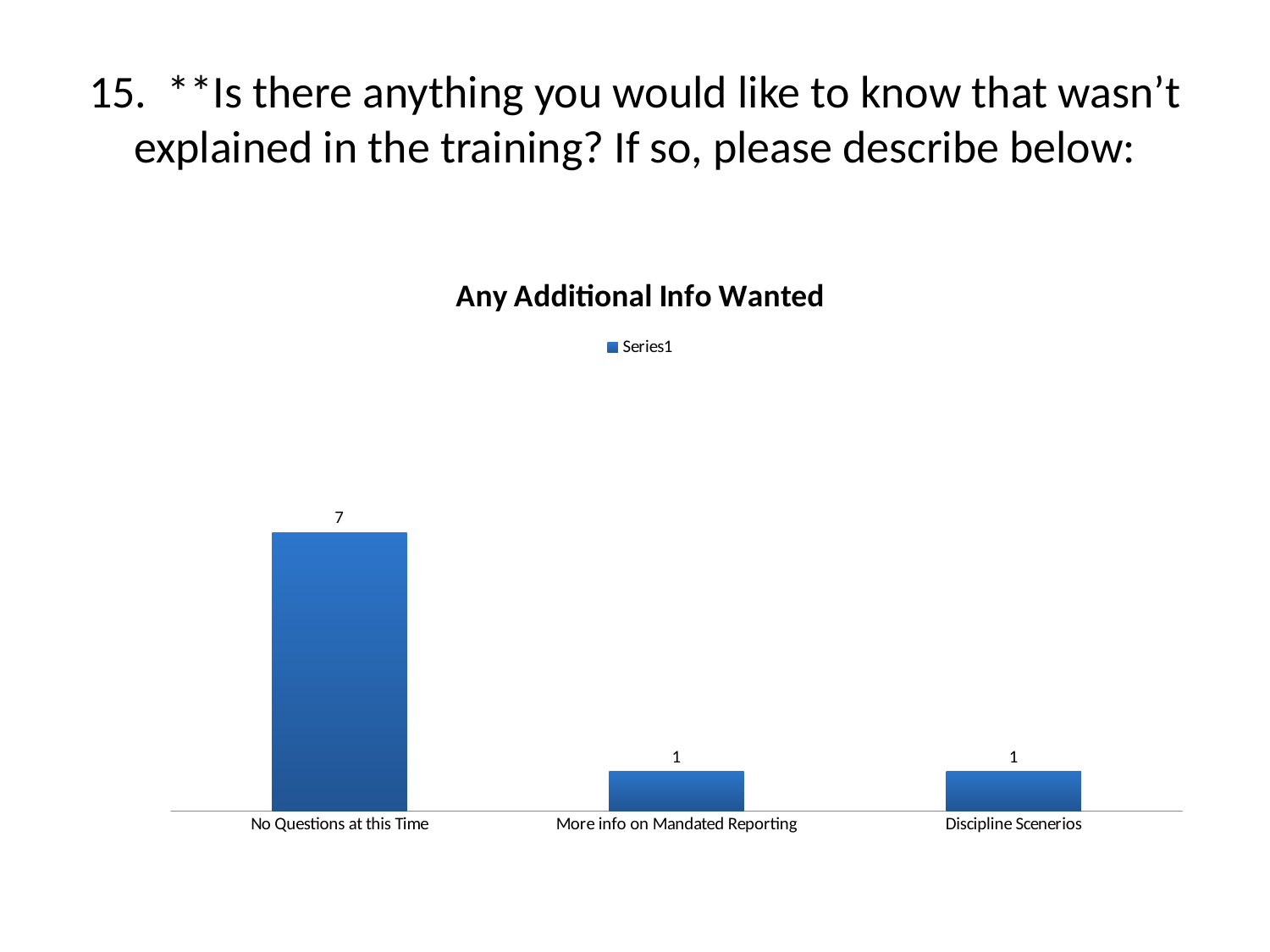
What is the value for Discipline Scenerios? 1 What is the title of the chart? Any Additional Info Wanted What is the value for More info on Mandated Reporting? 1 What is the value for No Questions at this Time? 7 Which is larger, the value for No Questions at this Time or the value for Discipline Scenerios? No Questions at this Time What is the total of all three bars in the chart? 9 Which category has the highest value? No Questions at this Time How many series does the legend list? 1 What is the name of the series shown in the legend? Series1 What is the difference between the values for No Questions at this Time and More info on Mandated Reporting? 6 How many categories are shown in the chart? 3 What kind of chart is shown on the slide? bar chart